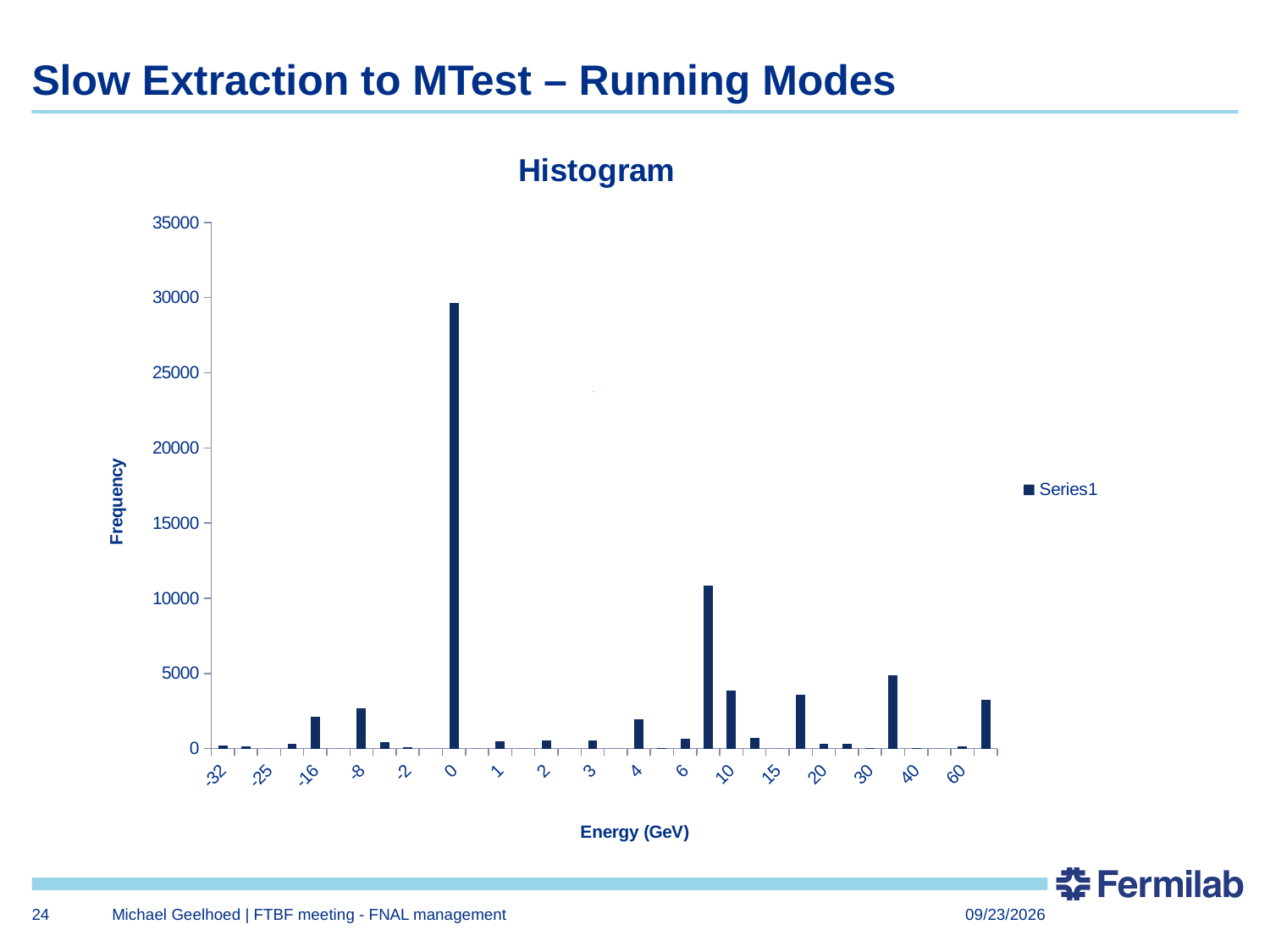
What kind of chart is shown on the slide? bar chart Which energy category has the highest frequency? 0 Is the frequency for energy 0 GeV greater or less than 25000? greater Which has the larger frequency, energy 0 GeV or energy 10 GeV? 0 Is the frequency for energy 10 GeV greater or less than 5000? less Which has the larger frequency, energy -32 GeV or energy 0 GeV? 0 What is the label of the x axis? Energy (GeV) Is the frequency for energy 1 GeV greater or less than 5000? less What is the title of the chart? Histogram How many series does the legend list? 1